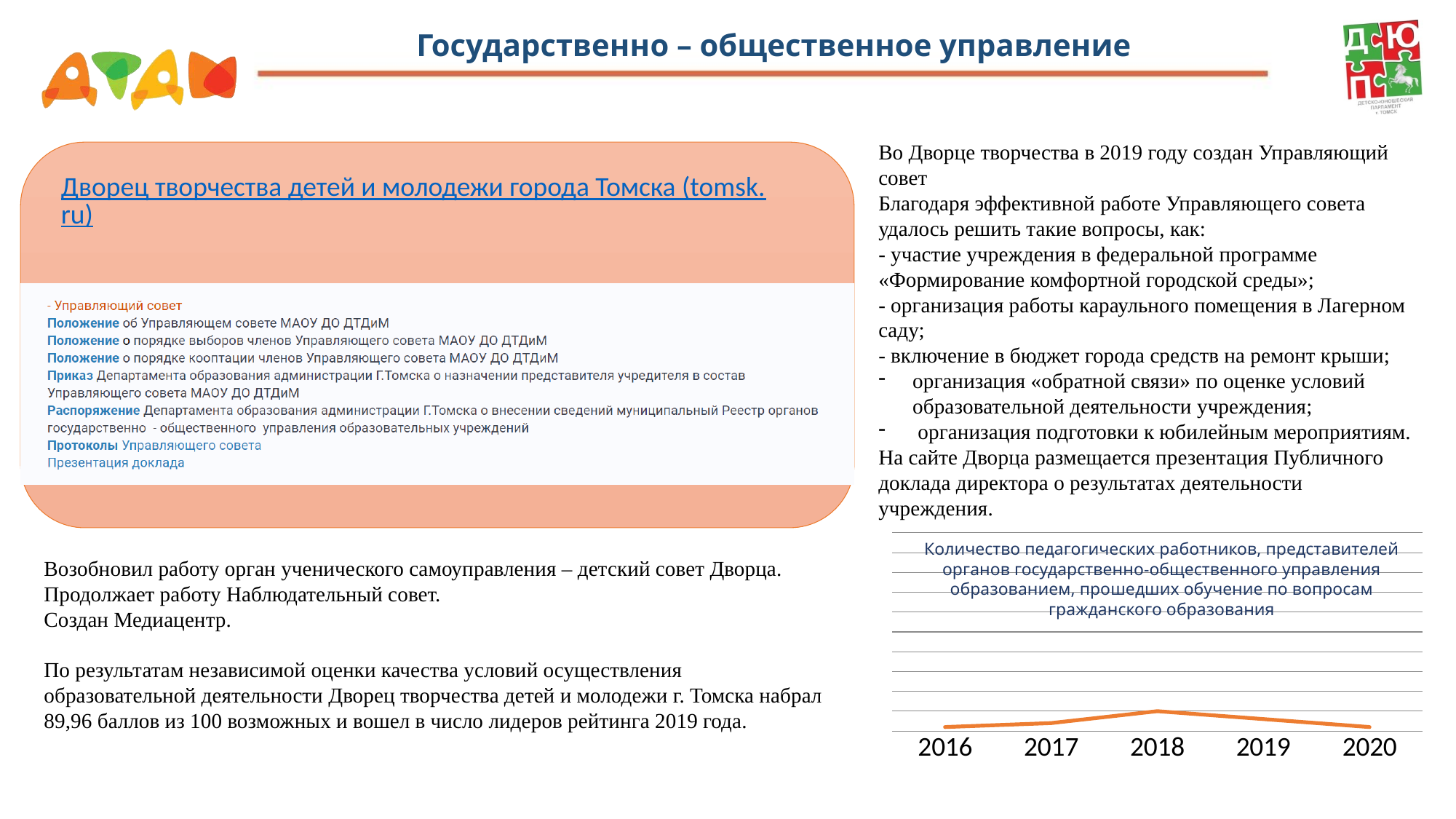
Does the line in the chart rise or fall from 2016 to 2018? rise Does the line in the chart rise or fall from 2018 to 2020? fall What is the last year shown on the x axis of the line chart? 2020 In the line chart, which is larger: the value for 2018 or the value for 2019? 2018 How many years are shown on the x axis of the line chart? 5 What is the first year shown on the x axis of the line chart? 2016 Which year has the highest value in the line chart? 2018 In the line chart, is the value for 2018 larger or smaller than the value for 2016? larger What kind of chart is shown at the bottom right of the slide? line chart In the line chart, which is larger: the value for 2018 or the value for 2020? 2018